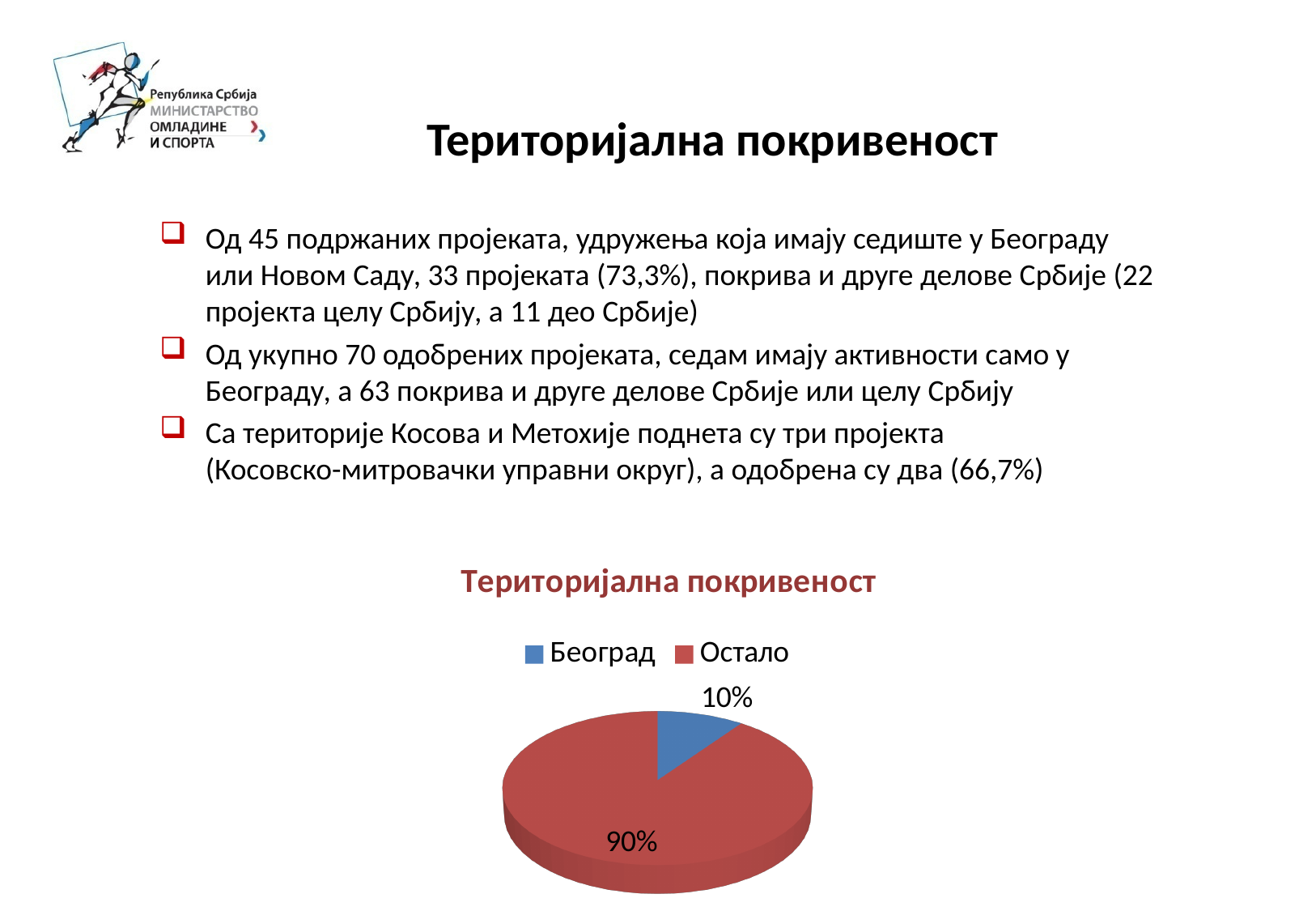
Which category has the largest slice of the pie? Остало How many slices does the pie chart have? 2 Which category has the smallest slice of the pie? Београд How many categories does the legend list? 2 What is the title of the chart? Територијална покривеност What colour is the Београд slice? blue Which slice is larger, Београд or Остало? Остало What is the difference in percentage points between the Остало and Београд slices? 80 What share of the pie does Београд represent? 10% What kind of chart is shown on the slide? pie chart What share of the pie does Остало represent? 90%